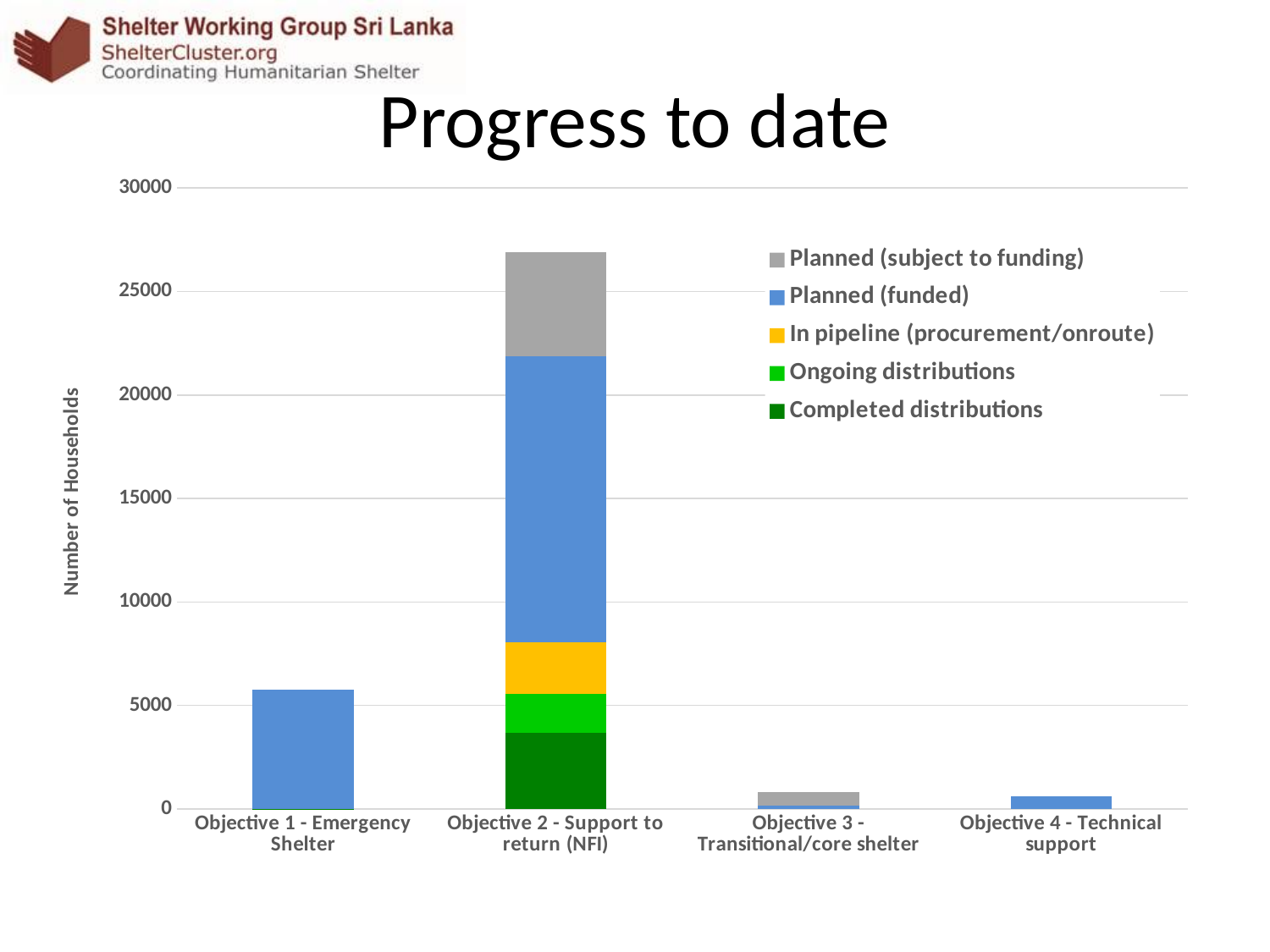
Is the value for Objective 1 - Emergency Shelter greater or less than 5000? greater How many series does the legend list? 5 What kind of chart is shown on the slide? Stacked bar chart Is the total value for Objective 2 - Support to return (NFI) greater or less than 25000? greater Is the Completed distributions segment for Objective 2 - Support to return (NFI) greater or less than 5000? less Which objective has the highest total number of households? Objective 2 - Support to return (NFI) What is the title of the chart? Progress to date Which has a larger total: Objective 1 - Emergency Shelter or Objective 2 - Support to return (NFI)? Objective 2 - Support to return (NFI) What is the label on the y axis? Number of Households How many objectives (categories) are shown on the x axis? 4 Which has a larger total: Objective 1 - Emergency Shelter or Objective 3 - Transitional/core shelter? Objective 1 - Emergency Shelter